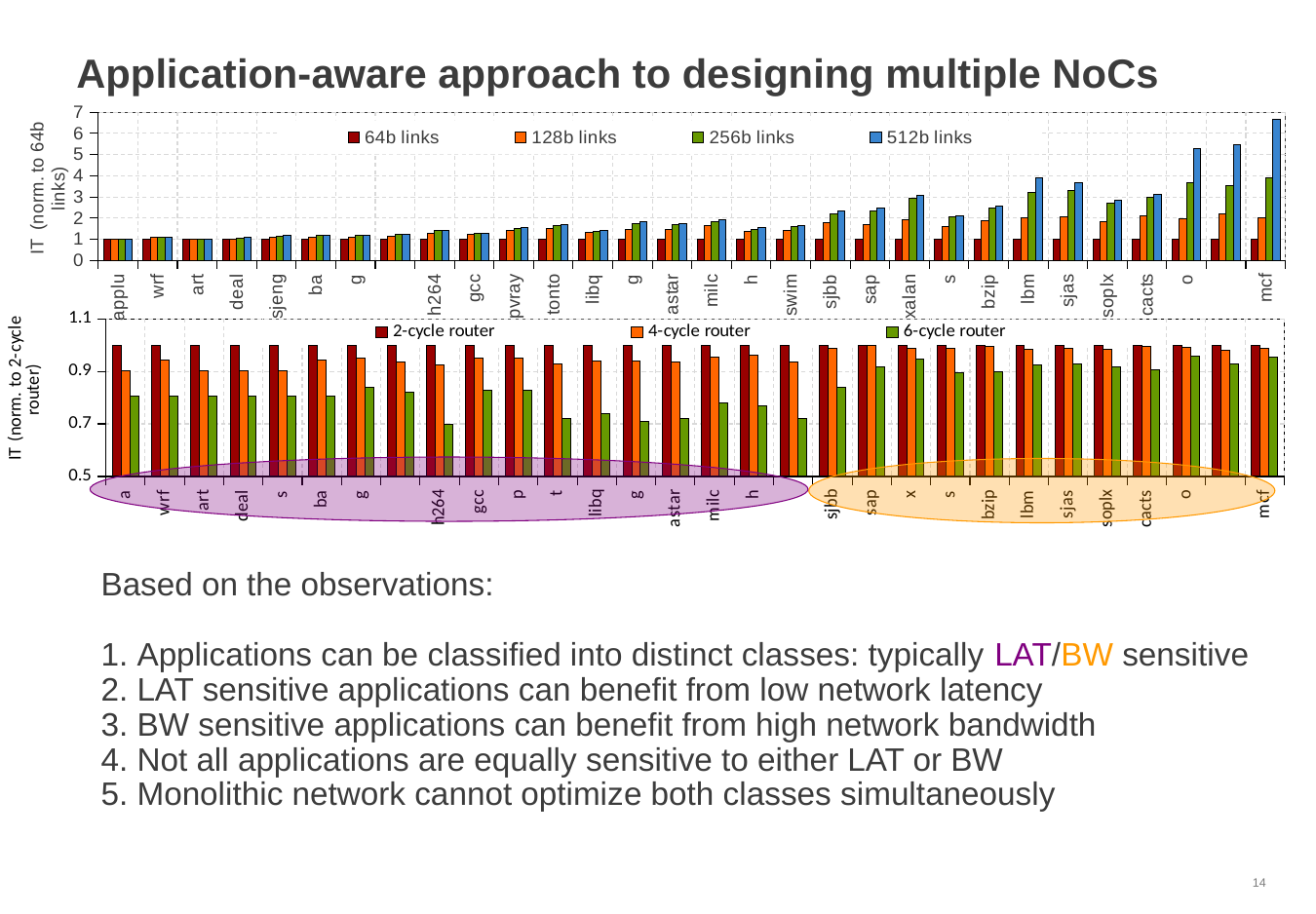
In the top chart, which is larger for mcf: the 256b links value or the 512b links value? 512b links What is the y-axis label of the bottom chart? IT (norm. to 2-cycle router) What colour are the 512b links bars in the top chart? blue In the bottom chart, is the 6-cycle router value for h264 greater or less than 0.9? less What kind of chart is the top chart? bar chart How many series does the legend of the bottom chart list? 3 In the top chart, is the 512b links value for lbm greater or less than 3? greater How many series does the legend of the top chart list? 4 In the bottom chart, which is larger: the 6-cycle router value for h264 or the 6-cycle router value for mcf? mcf In the top chart, is the 512b links value for applu greater or less than 2? less In the top chart, which category has the highest 512b links value? mcf